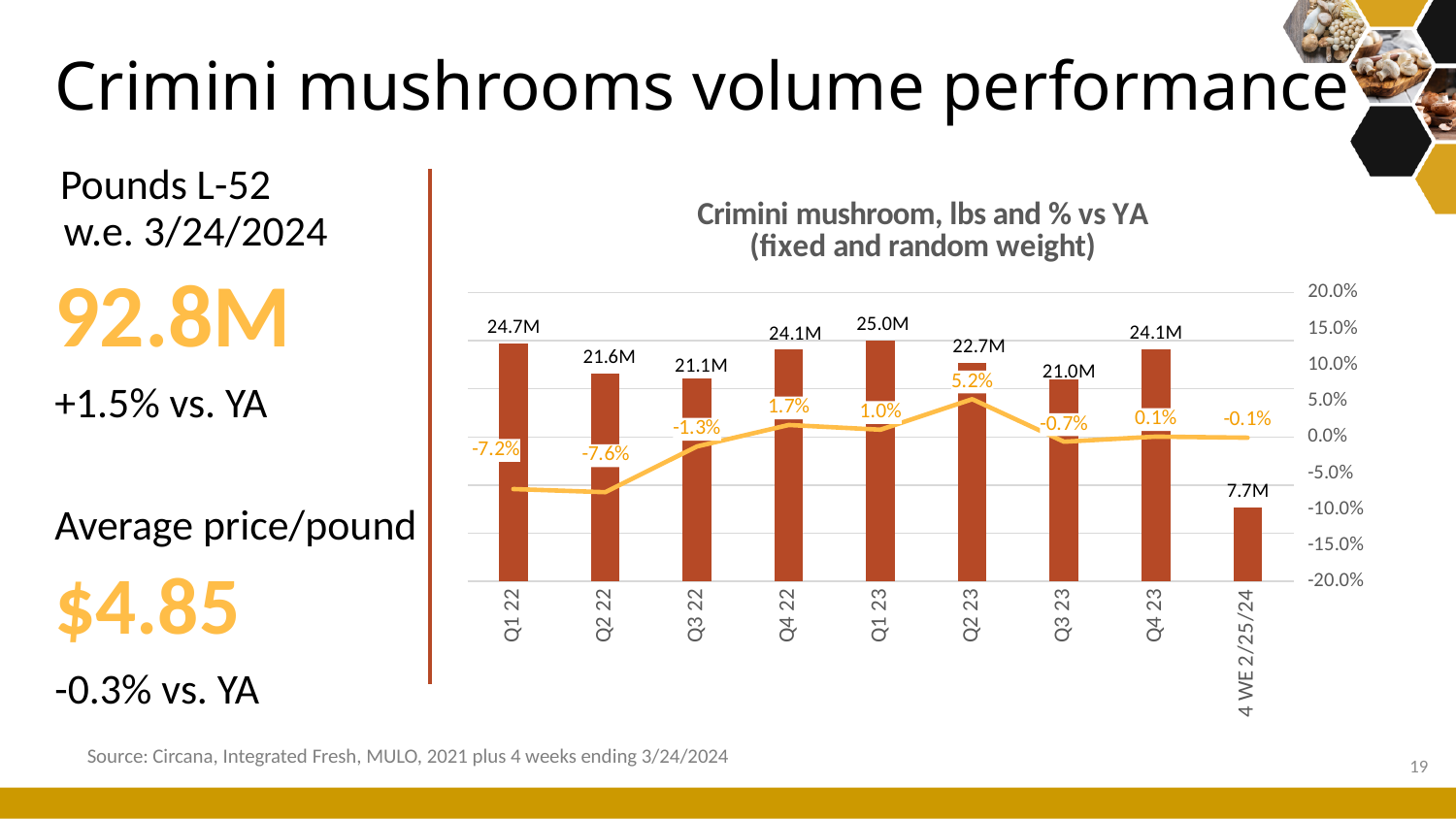
Which period has the lowest % vs YA value? Q2 22 What is the difference in pounds between Q1 22 and Q2 22? 3.1M What is the pounds value for Q1 23? 25.0M Which has a higher pounds value, Q4 22 or Q3 23? Q4 22 Which period has the highest pounds value? Q1 23 What is the % vs YA value for Q2 23? 5.2% What is the title of the chart? Crimini mushroom, lbs and % vs YA (fixed and random weight) What is the pounds value for the 4 WE 2/25/24 period? 7.7M Does the % vs YA line rise or fall from Q2 22 to Q2 23? Rise What is the % vs YA value for Q2 22? -7.6% What kind of chart is this? Combination bar and line chart How many periods are shown on the x axis? 9